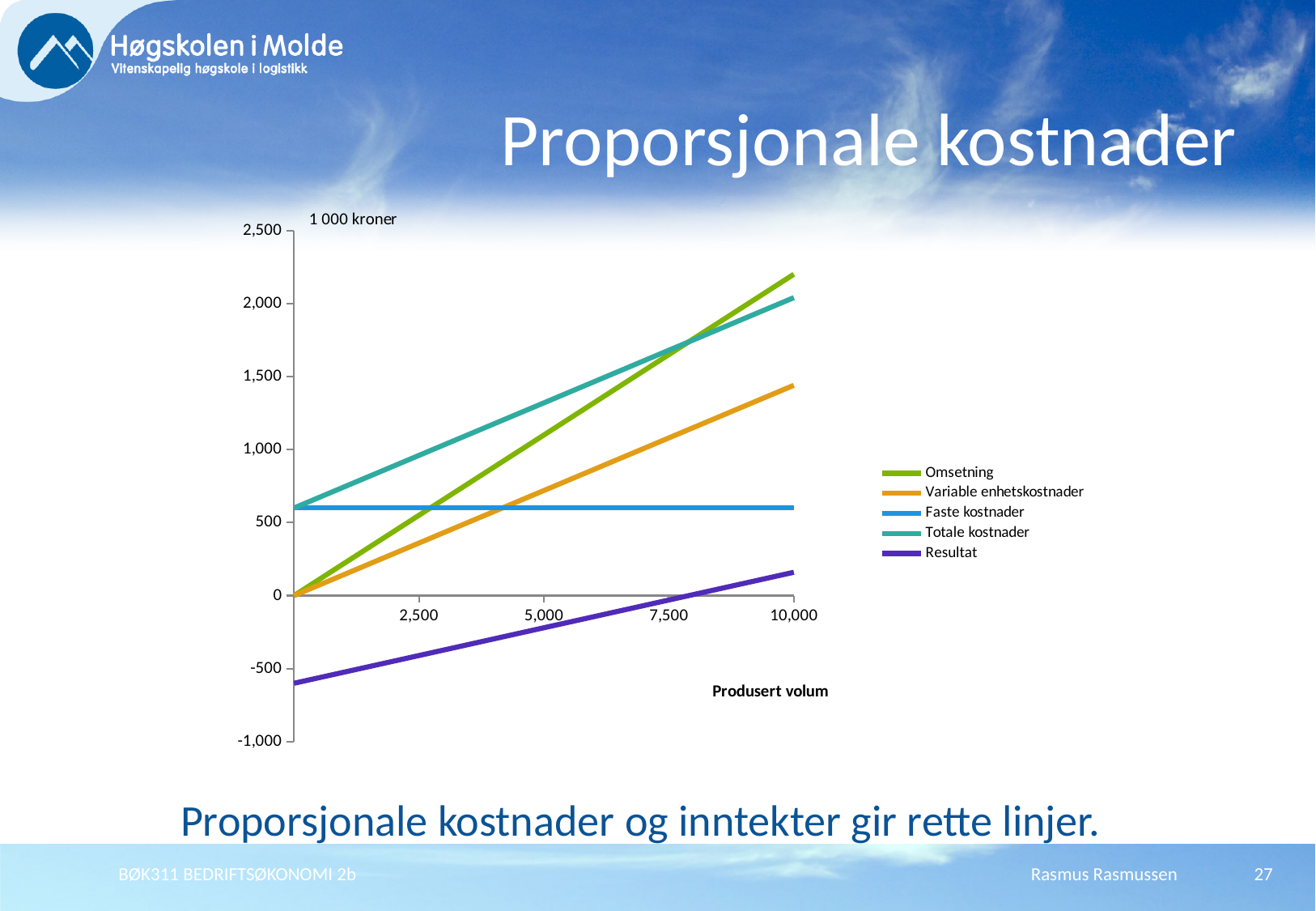
Is the value of Omsetning at a volume of 10,000 greater or less than 2,000? greater Which series has the highest value at a volume of 10,000? Omsetning At a volume of 10,000, which is larger: Omsetning or Totale kostnader? Omsetning How many series does the legend list? 5 Is the value of Resultat at a volume of 2,500 greater or less than 0? less What unit label is shown at the top of the y axis? 1 000 kroner What is the title of the x axis? Produsert volum Is the value of Faste kostnader greater or less than 500? greater Which series has the lowest value at a volume of 10,000? Resultat Does the Faste kostnader line rise, fall or stay flat as volume increases? stays flat What kind of chart is shown on the slide? line chart